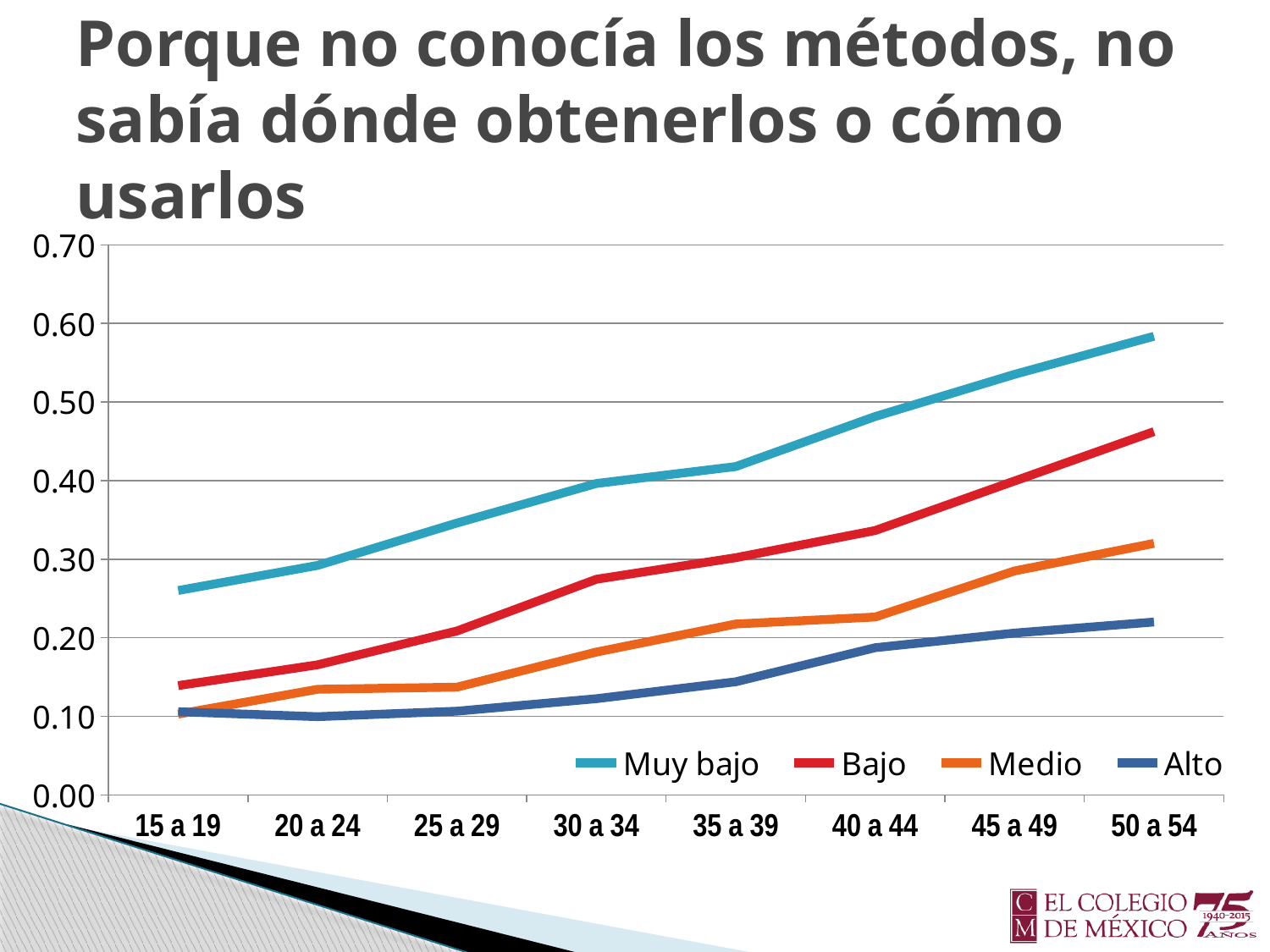
Which series is drawn in red in the legend? Bajo Is the value for Muy bajo at 50 a 54 greater or less than 0.50? greater Is the value for Bajo at 15 a 19 greater or less than 0.20? less Does the Muy bajo line rise or fall from 15 a 19 to 50 a 54? rise Which series has the highest value at 50 a 54? Muy bajo How many age-group categories are shown on the x axis? 8 At 30 a 34, which is larger: the value for Bajo or the value for Medio? Bajo Which series has the lowest value at 50 a 54? Alto How many series does the legend list? 4 Is the value for Medio at 50 a 54 greater or less than 0.30? greater What kind of chart is shown on the slide? line chart